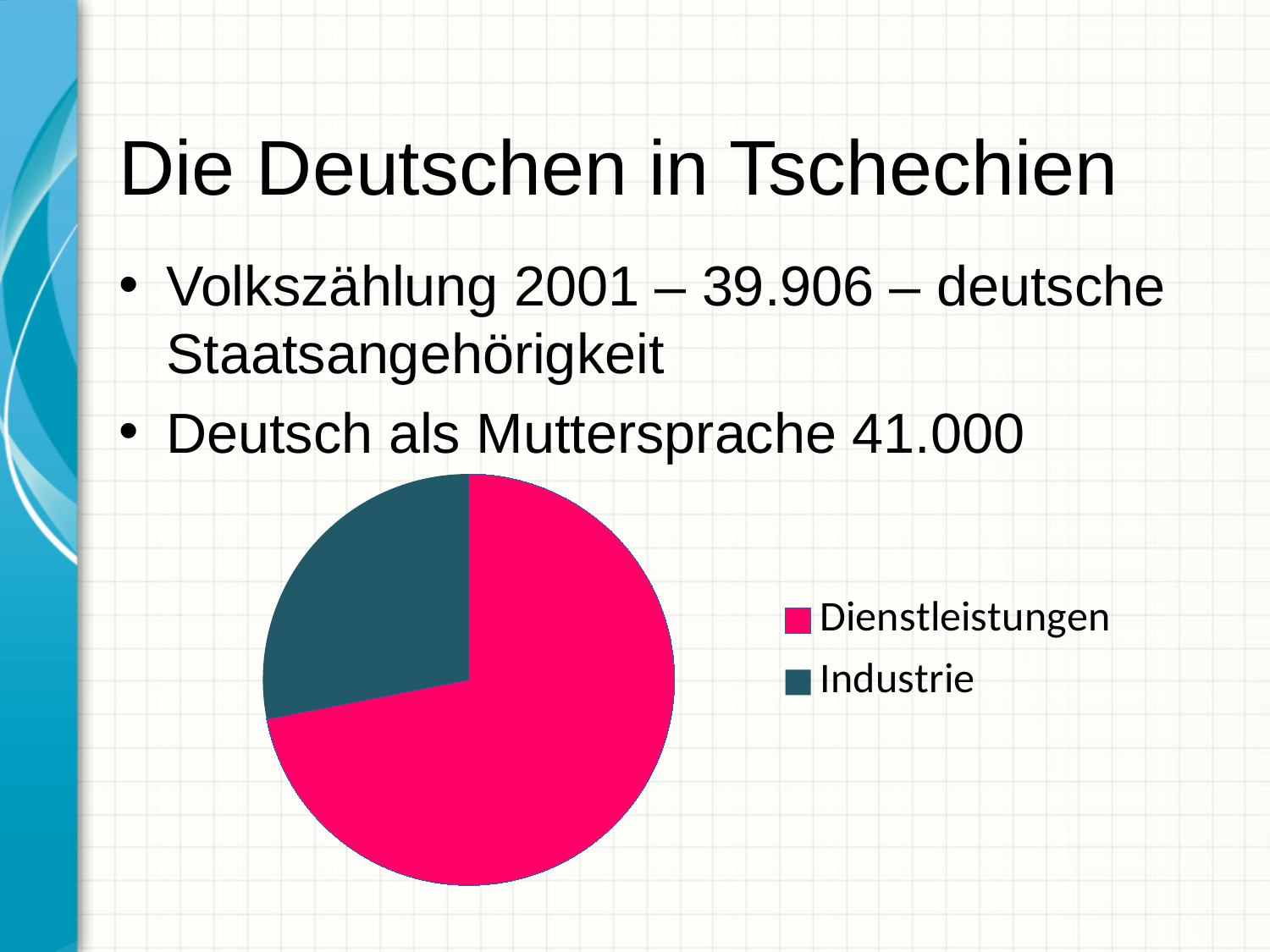
How many slices does the pie chart have? 2 How many entries does the legend of the pie chart list? 2 What kind of chart is shown on the slide? pie chart Which category has the smallest slice in the pie chart? Industrie Which category has the largest slice in the pie chart? Dienstleistungen Does the Dienstleistungen slice take up more or less than half of the pie chart? more Which slice is larger in the pie chart, Dienstleistungen or Industrie? Dienstleistungen What colour is the Industrie slice in the pie chart? dark teal Which category is shown in pink in the pie chart? Dienstleistungen